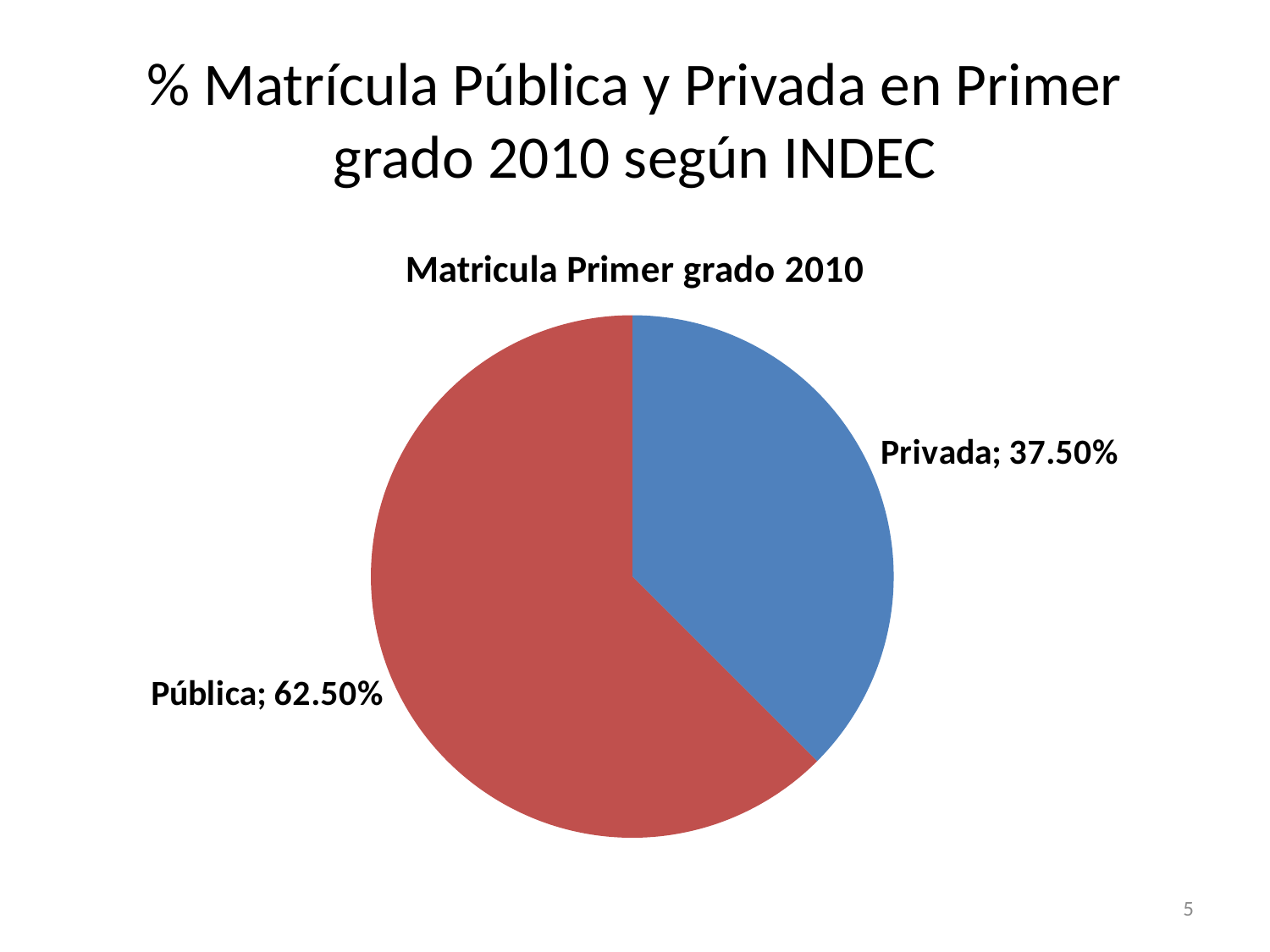
What is the value for Pública? 62.50% How many slices does the pie chart have? 2 What is the difference between the Pública and Privada values? 25.00% What colour is the Pública slice? red What is the value for Privada? 37.50% What share of the pie does Privada represent? 37.50% Which is larger, Pública or Privada? Pública What kind of chart is shown on the slide? pie chart What is the chart's title? Matricula Primer grado 2010 Which category has the smallest slice? Privada Which category has the largest slice? Pública